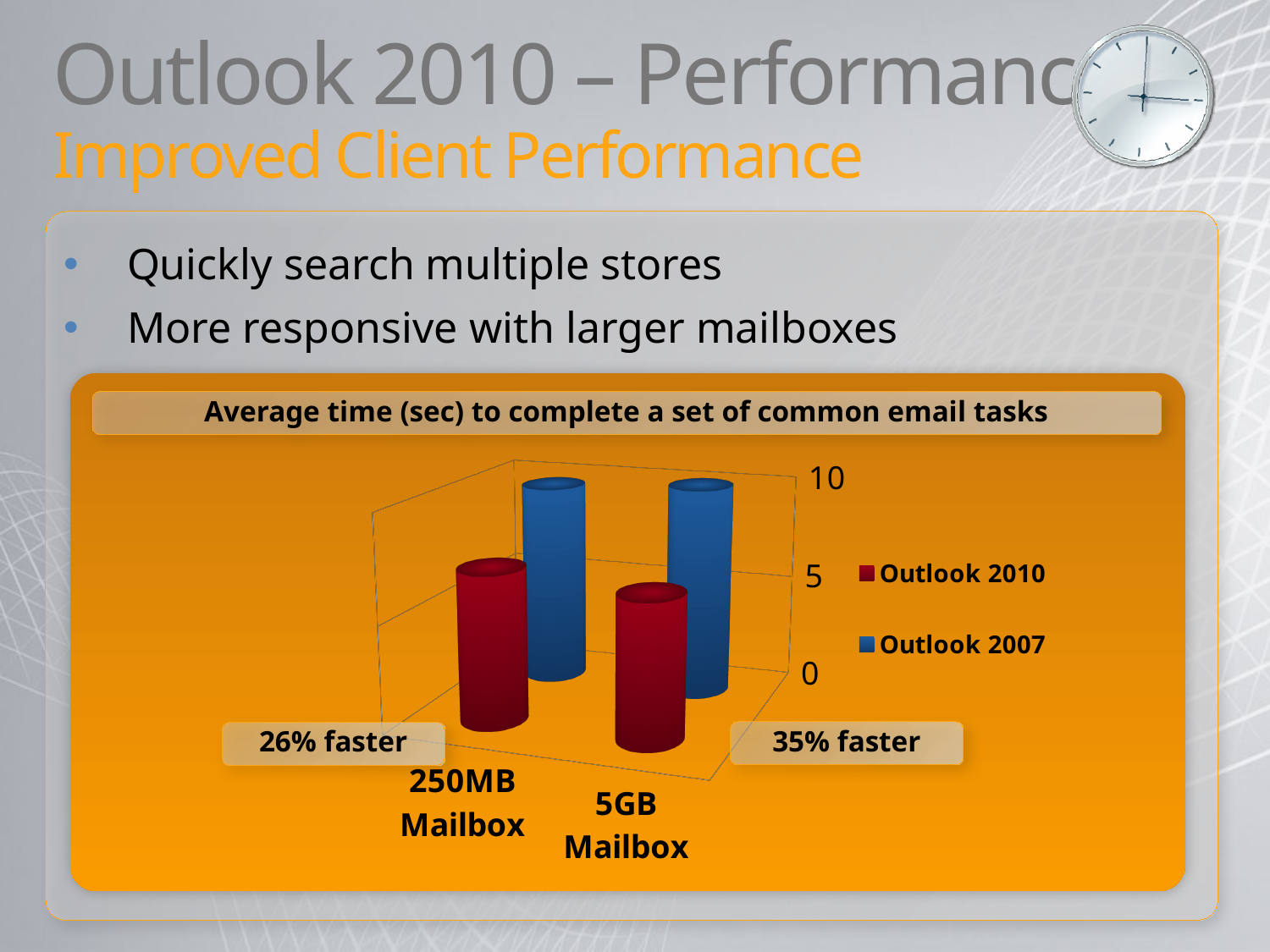
Which series has the higher value for the 5GB Mailbox, Outlook 2010 or Outlook 2007? Outlook 2007 Is the Outlook 2010 value for the 5GB Mailbox greater or less than 10? less What kind of chart is shown on the slide? bar chart How many series does the chart legend list? 2 Is the Outlook 2007 value for the 250MB Mailbox greater or less than 5? greater Which series has the higher value for the 250MB Mailbox, Outlook 2010 or Outlook 2007? Outlook 2007 What is the title of the chart? Average time (sec) to complete a set of common email tasks Which colour represents Outlook 2007 in the chart? blue How many mailbox categories are shown on the chart? 2 According to the annotation on the chart, how much faster is Outlook 2010 for the 5GB Mailbox? 35% faster Which series has the lowest values across both mailbox sizes? Outlook 2010